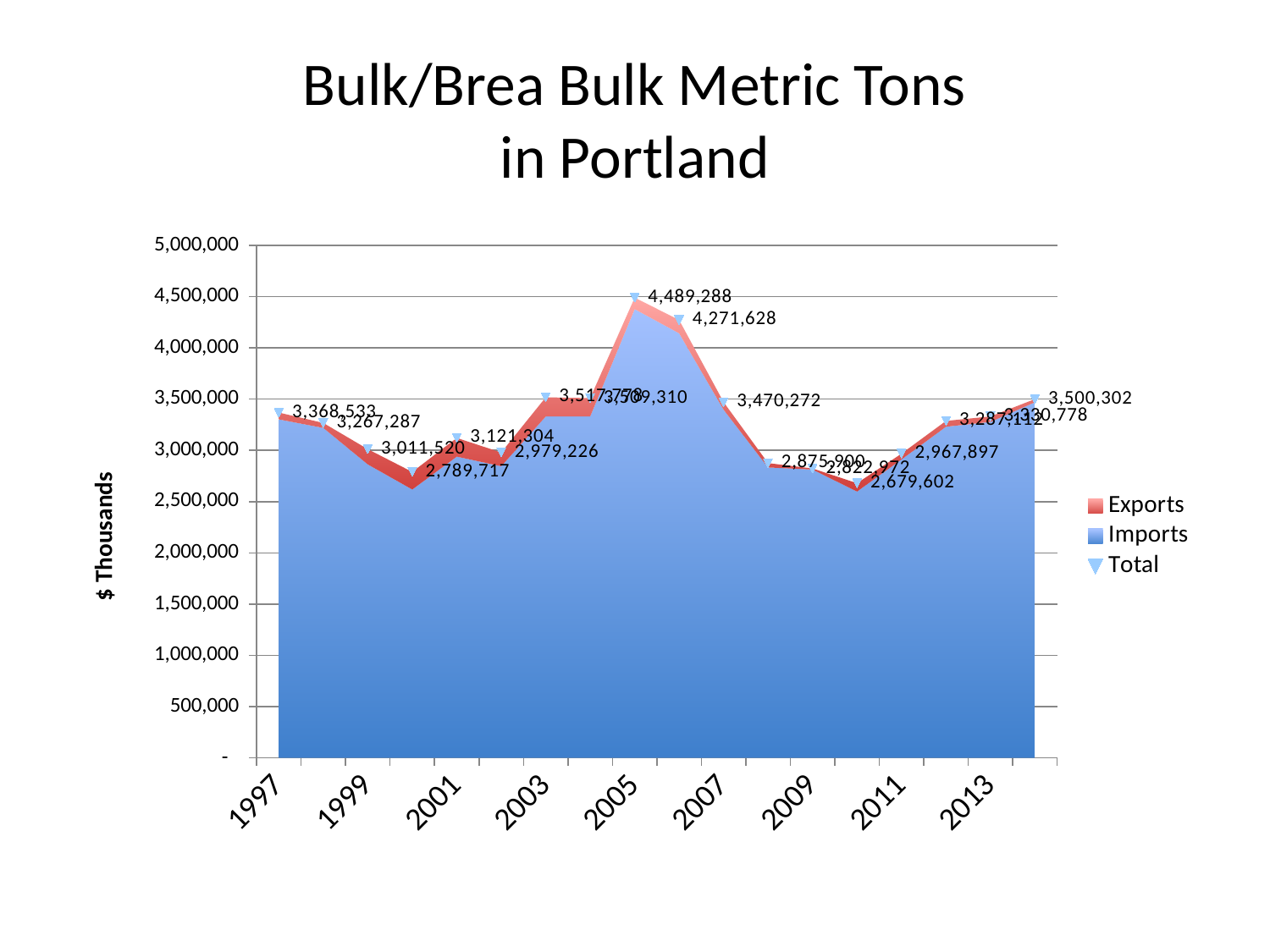
Which year has the larger Total, 1997 or 2011? 1997 What is the Total value for 2007? 3,470,272 In which year is the Total highest? 2005 Does the Total rise or fall from 2005 to 2007? fall How many series does the legend list? 3 What is the Total value for 2005? 4,489,288 What is the difference between the Total for 2005 and the Total for 2007? 1,019,016 What is the Total value for 1997? 3,368,533 What is the Total value for 1999? 3,011,520 What is the Total value for 2011? 2,967,897 What is the lowest Total value labelled on the chart? 2,679,602 Is the Total for 2005 greater or less than 4,000,000? greater